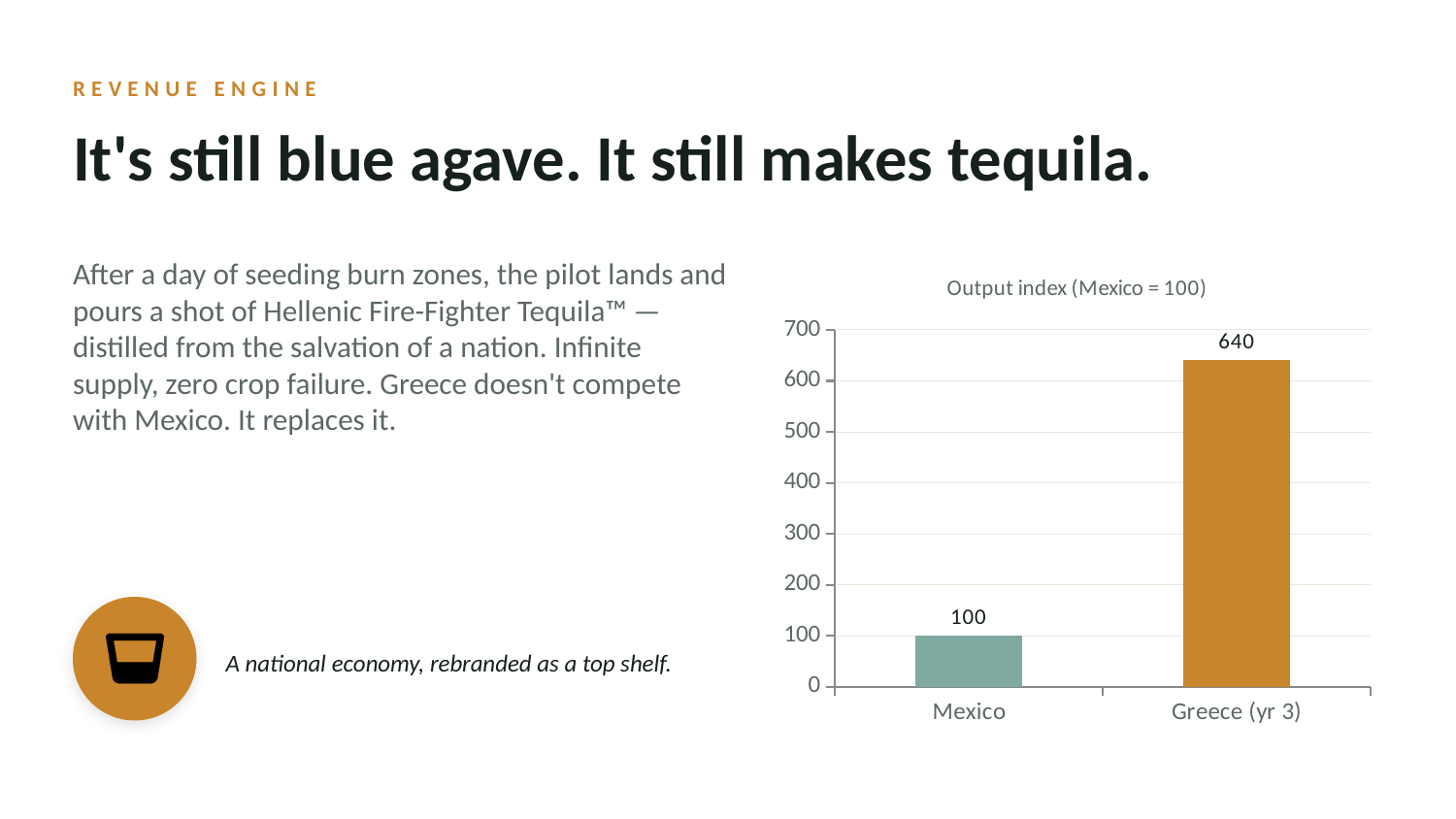
Which category has the lowest value in the chart? Mexico What is the highest value shown on the chart's vertical axis? 700 Is the value for Greece (yr 3) greater or less than 600? greater How many categories are shown in the chart? 2 Which category has the highest value in the chart? Greece (yr 3) What is the value for Mexico in the chart? 100 Which is larger, the value for Mexico or the value for Greece (yr 3)? Greece (yr 3) What is the difference between the values for Greece (yr 3) and Mexico? 540 Is the value for Mexico greater or less than 200? less What is the title of the chart? Output index (Mexico = 100) What kind of chart is shown on the slide? bar chart What is the value for Greece (yr 3) in the chart? 640